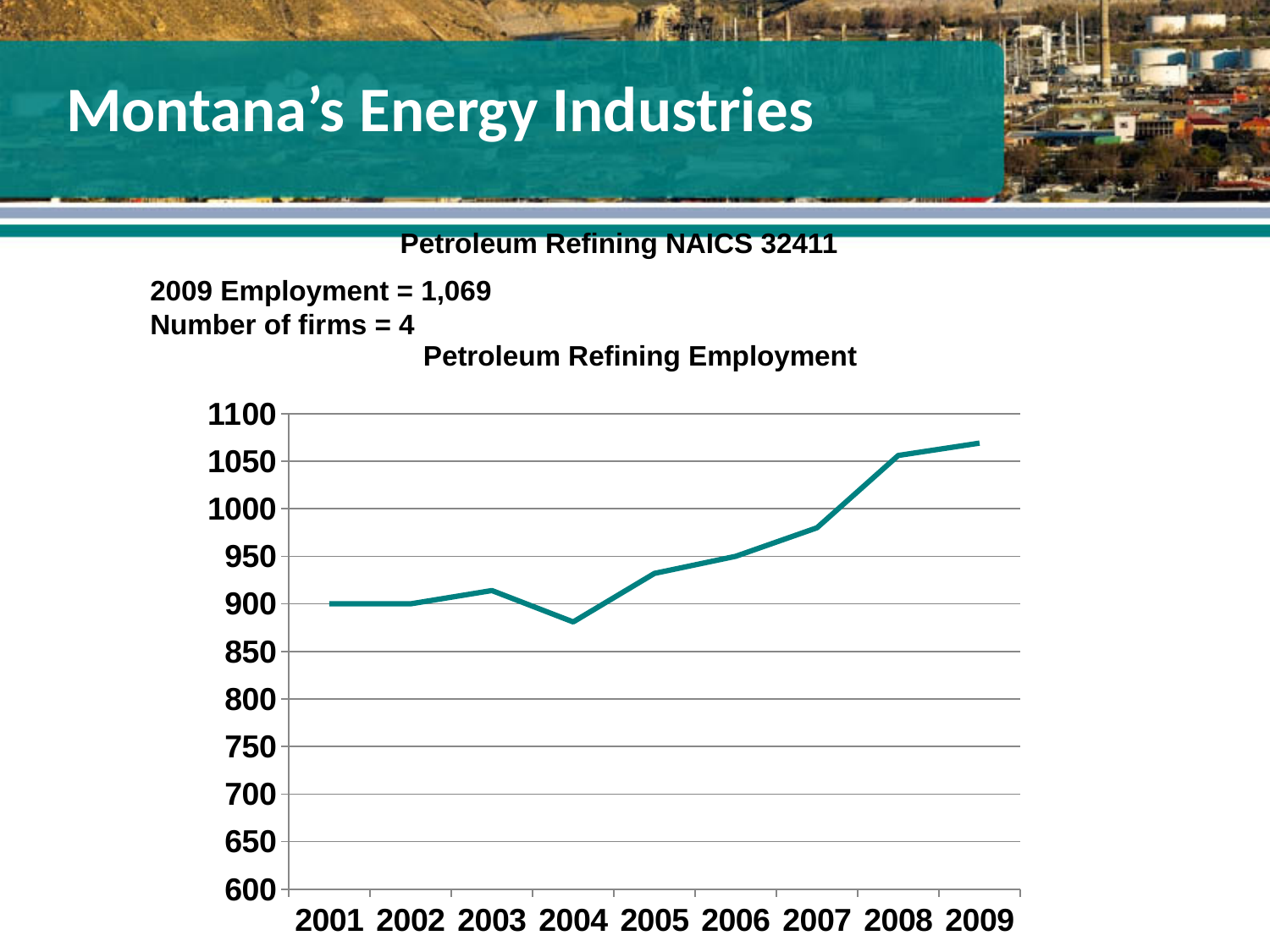
Overall, does petroleum refining employment rise or fall from 2001 to 2009? rise Is the value for 2004 greater or less than 900? less Which year has the larger employment value, 2003 or 2004? 2003 Which year has the highest petroleum refining employment? 2009 Is the value for 2008 greater or less than 1000? greater What is the title of the chart? Petroleum Refining Employment Which year has the lowest petroleum refining employment? 2004 How many years are plotted on the x axis of the chart? 9 Is the value for 2007 greater or less than 1000? less What kind of chart is shown on the slide? line chart Which year has the larger employment value, 2001 or 2009? 2009 What is the petroleum refining employment value for 2009? 1,069